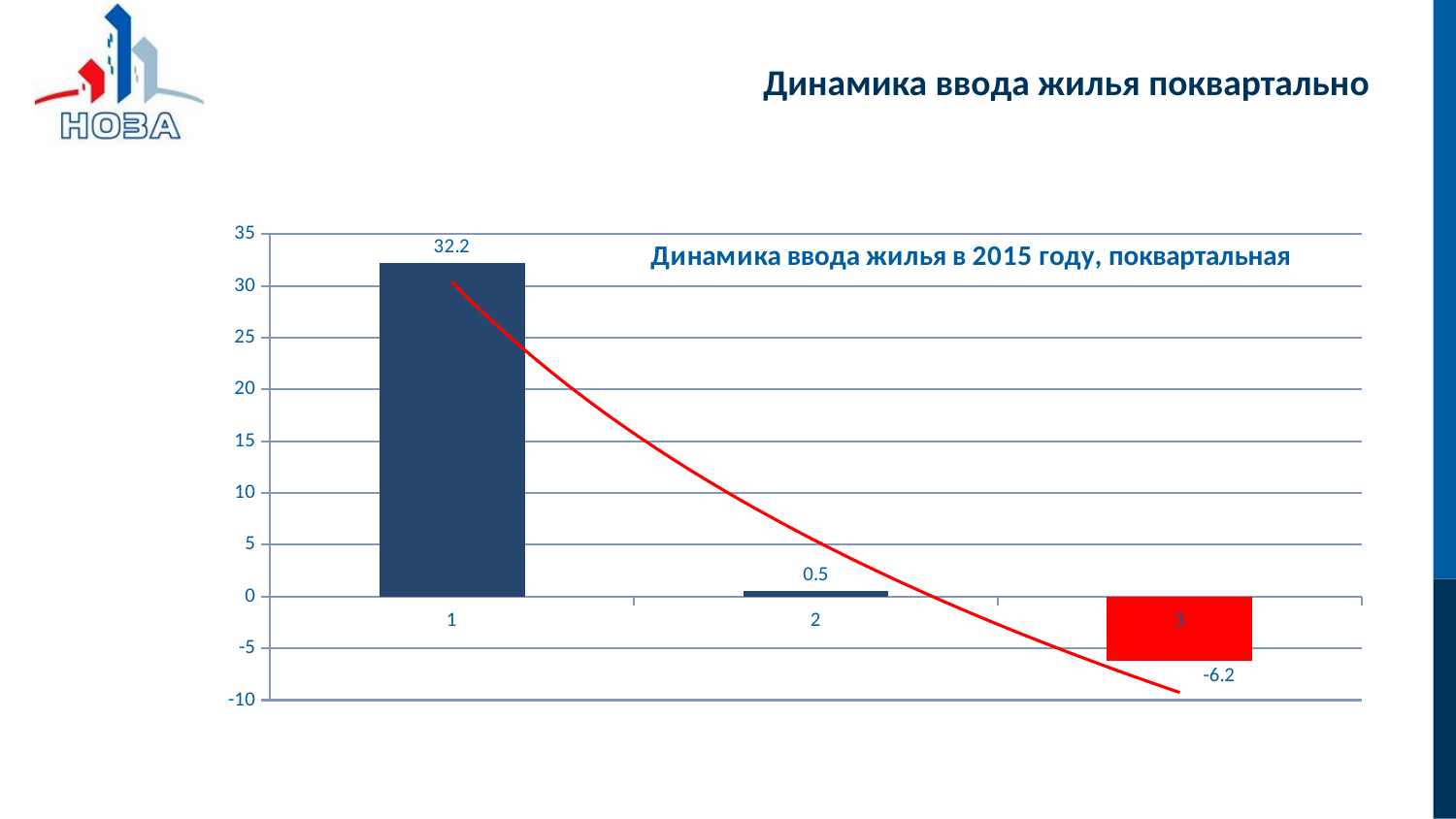
Do the values rise or fall from category 1 to category 3? fall Which is larger, the value for category 2 or the value for category 3? category 2 What is the difference between the values for category 2 and category 3? 6.7 What is the difference between the values for category 1 and category 2? 31.7 What is the title of the chart? Динамика ввода жилья в 2015 году, поквартальная Which category has the lowest value? 3 How many categories are shown on the x axis? 3 What is the value for category 3? -6.2 What is the value for category 2? 0.5 What is the value for category 1? 32.2 What kind of chart is this? bar chart Which category has the highest value? 1